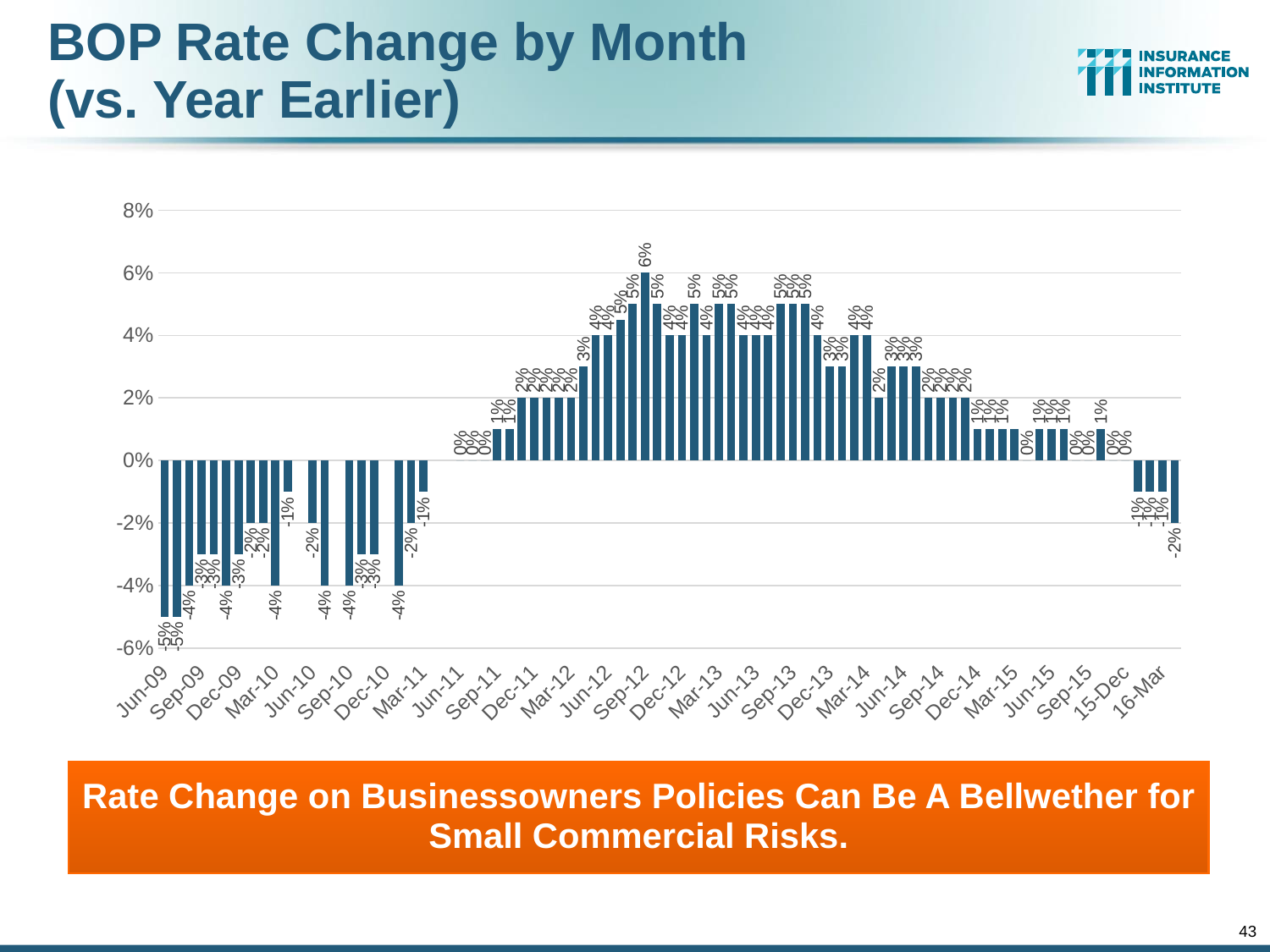
Is the value for Mar-10 greater or less than 0%? less What is the title of the slide containing the chart? BOP Rate Change by Month (vs. Year Earlier) What kind of chart is shown on the slide? Bar chart What is the lowest rate change value shown in the chart? -5% Is the value for Sep-12 greater or less than 4%? greater How many month labels are shown on the x axis of the chart? 28 Do the rate change values generally rise or fall from Sep-12 to 16-Mar? Fall Which has the larger rate change, Jun-09 or Sep-12? Sep-12 What is the highest rate change value shown in the chart? 6% What is the BOP rate change for Jun-09, the first bar in the chart? -5% What is the difference between the highest value (6%) and the lowest value (-5%) in the chart? 11 percentage points